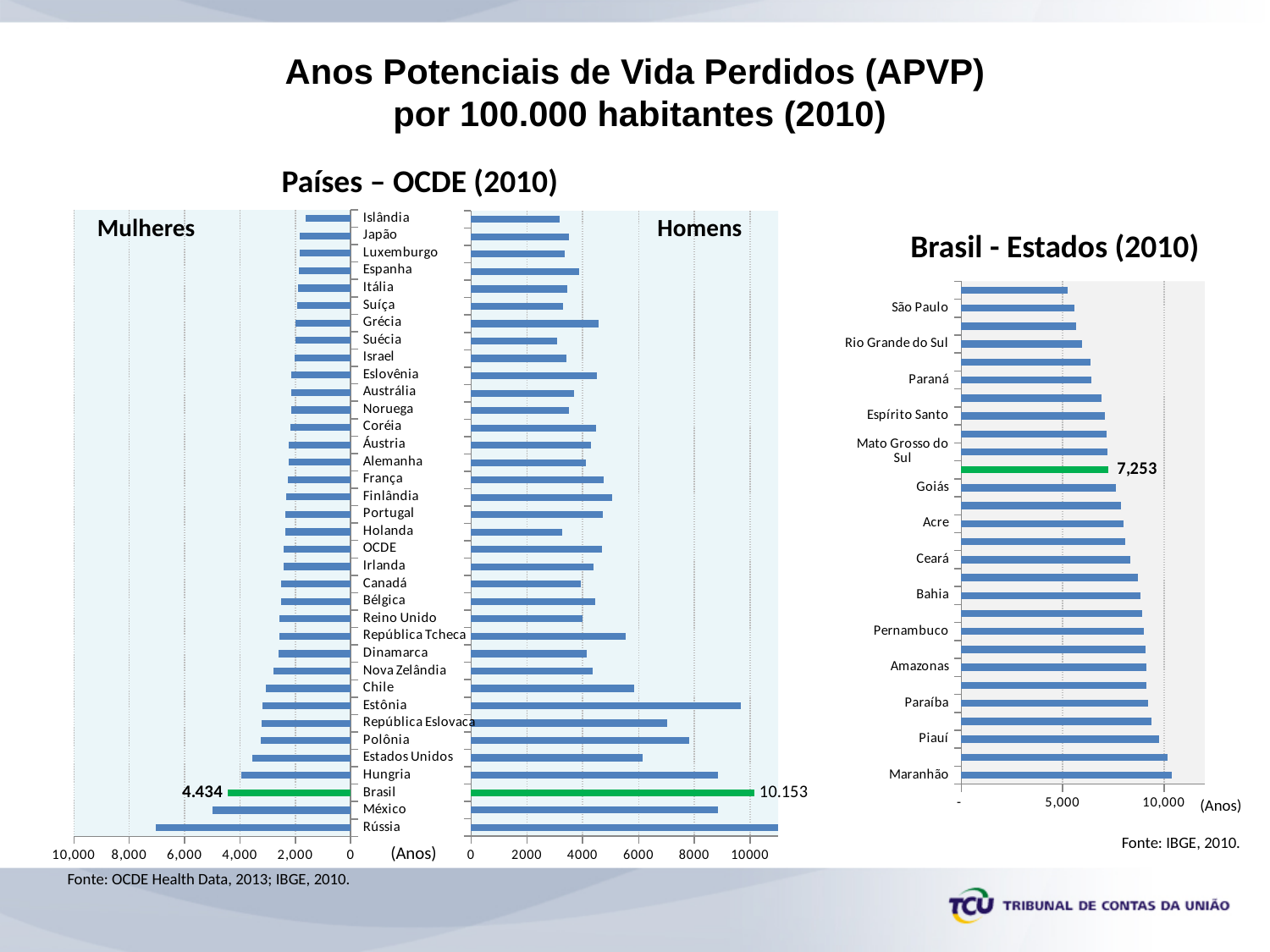
In the Países – OCDE (2010) chart, what is the Mulheres value for Brasil? 4.434 In the Países – OCDE (2010) chart, is the Homens value for Estônia greater or less than 8000? greater In the Países – OCDE (2010) chart, is the Mulheres value for Estados Unidos greater or less than 2,000? greater In the Países – OCDE (2010) chart, what is the difference between the Homens and Mulheres values for Brasil? 5.719 In the Países – OCDE (2010) chart, on which side of the country labels are the Mulheres bars shown? Left In the Países – OCDE (2010) chart, which country has the highest Mulheres value? Rússia In the Brasil - Estados (2010) chart, is the value for Maranhão greater or less than 10,000? greater In the Países – OCDE (2010) chart, which is larger: the Homens value for Brasil or the Homens value for Hungria? Brasil In the Países – OCDE (2010) chart, what is the Homens value for Brasil? 10.153 What kind of chart is the Brasil - Estados (2010) chart? Bar chart In the Brasil - Estados (2010) chart, what value is printed on the green highlighted bar? 7,253 In the Países – OCDE (2010) chart, which country has the highest Homens value? Rússia